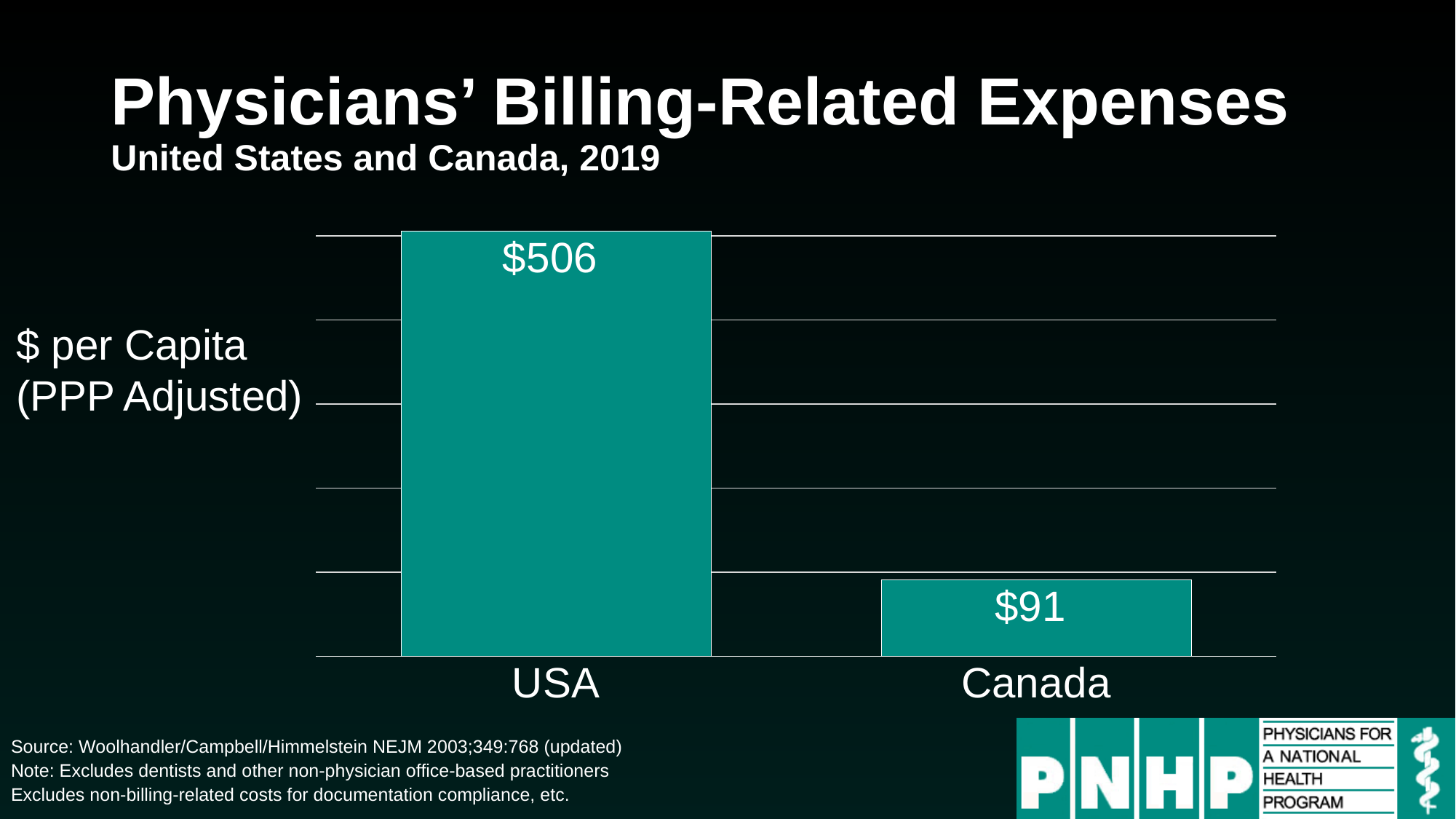
What is the value for Canada? $91 What kind of chart is shown on the slide? Bar chart Which is larger, the value for USA or the value for Canada? USA What unit is given for the values on the chart? $ per Capita (PPP Adjusted) Which category has the highest value? USA What is the value for USA? $506 What is the title of the chart? Physicians' Billing-Related Expenses What is the difference between the USA and Canada values? $415 How many categories are shown in the chart? 2 Which category has the lowest value? Canada